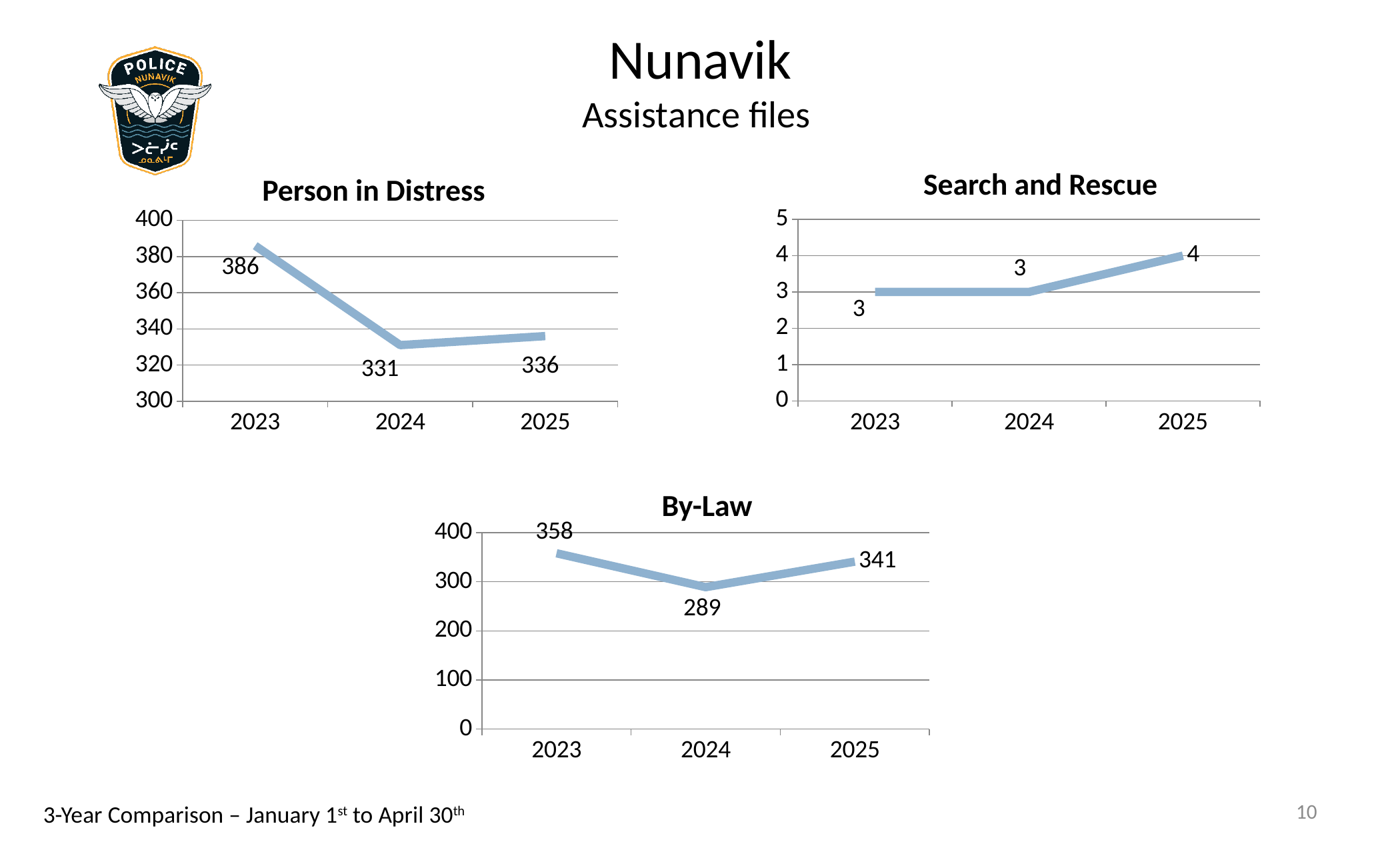
What kind of chart is the Person in Distress chart? Line chart In the Search and Rescue chart, what is the value for 2025? 4 In the Person in Distress chart, what is the value for 2023? 386 In the By-Law chart, what is the value for 2024? 289 In the Person in Distress chart, which year has the lowest value? 2024 In the By-Law chart, which is larger, the value for 2023 or the value for 2025? 2023 In the Search and Rescue chart, how many data points are plotted? 3 In the Person in Distress chart, do the values rise or fall from 2023 to 2024? Fall In the By-Law chart, is the value for 2024 greater or less than 300? less In the Search and Rescue chart, which year has the highest value? 2025 In the Person in Distress chart, what is the difference between the 2023 and 2024 values? 55 In the By-Law chart, what is the difference between the 2025 and 2024 values? 52